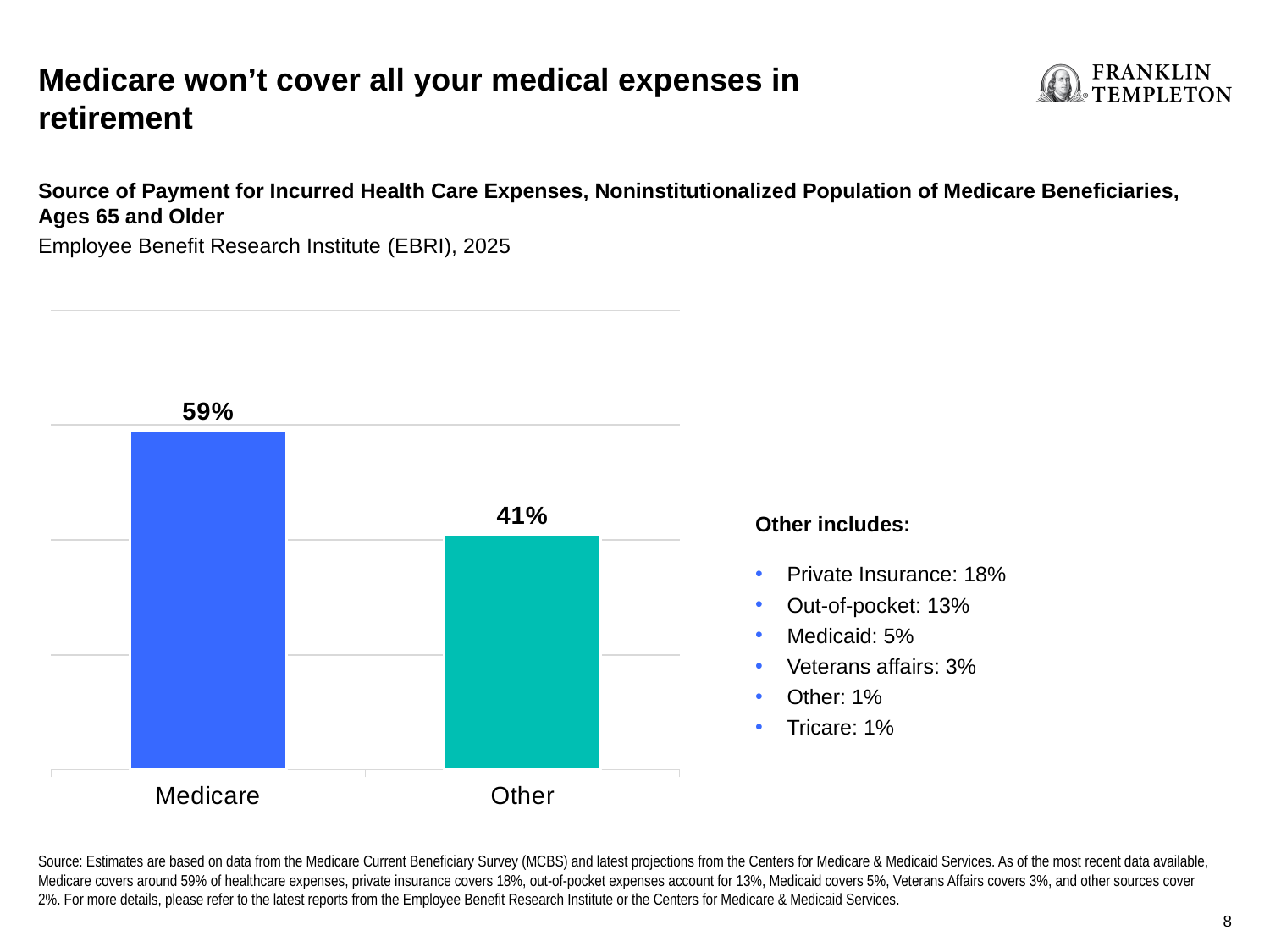
What is the difference between the Medicare and Other values? 18% What is the total of the Medicare and Other values? 100% What colour is the Other bar? Teal Which is larger, the value for Medicare or the value for Other? Medicare Which category has the highest value? Medicare What is the value for Medicare? 59% What kind of chart is shown on the slide? Bar chart What is the value for Other? 41% What colour is the Medicare bar? Blue Which category has the lowest value? Other How many categories are shown on the x axis? 2